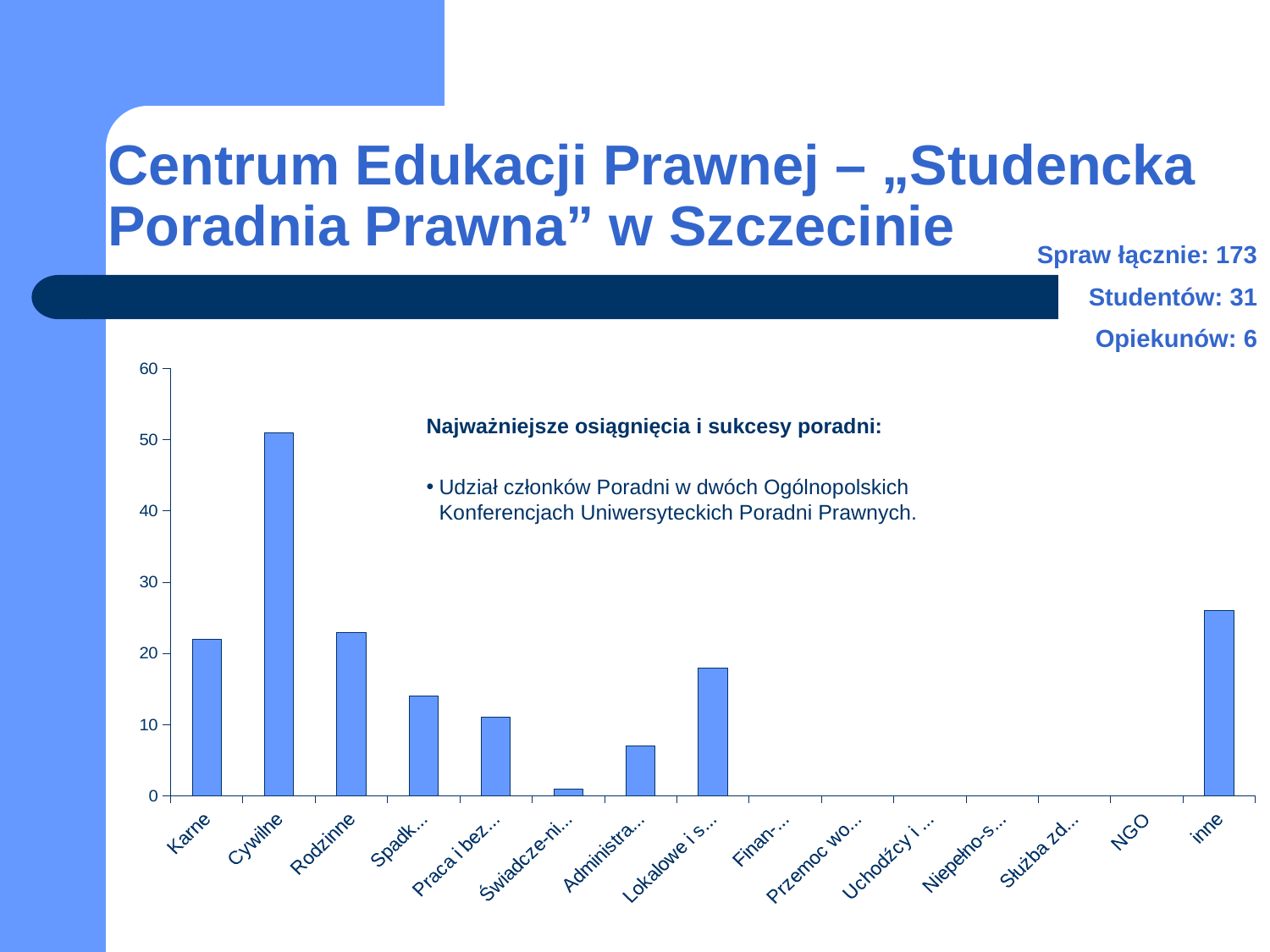
Is the value for Cywilne greater or less than 40? greater What is the highest value shown on the y axis of the chart? 60 Is the value for Rodzinne greater or less than 30? less Is the value for inne greater or less than 20? greater Which is larger, the value for Cywilne or the value for inne? Cywilne What kind of chart is shown on the slide? bar chart How many categories are shown on the x axis of the chart? 15 What is the interval between the tick marks on the y axis? 10 Which is larger, the value for Rodzinne or the value for NGO? Rodzinne Which category has the highest bar in the chart? Cywilne